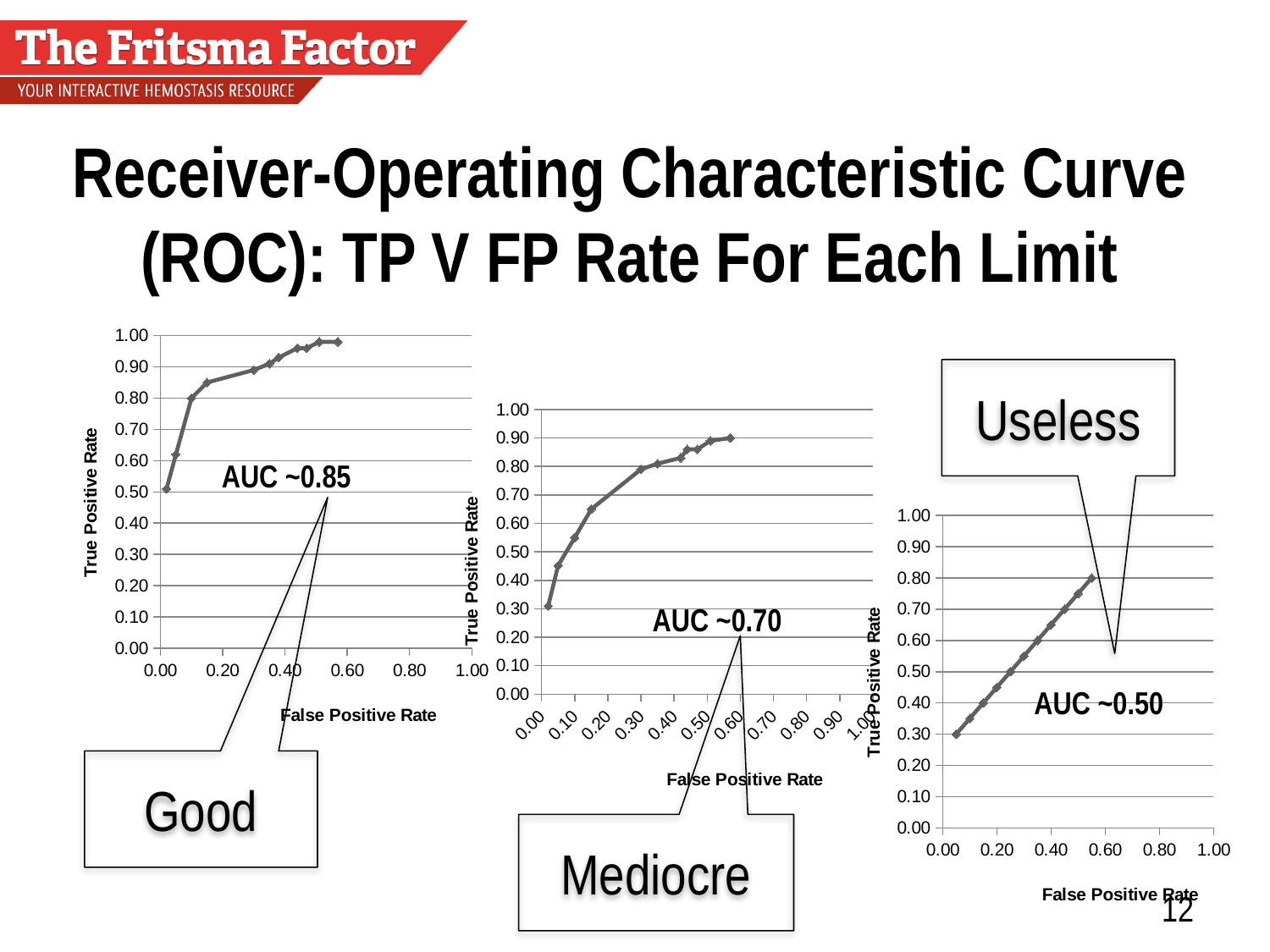
Which of the three charts reaches the lowest maximum true positive rate? the right chart (Useless) On the left chart labelled "Good", do the values rise or fall as the false positive rate increases? rise On the middle chart labelled "Mediocre", what is the label of the x axis? False Positive Rate On the left chart labelled "Good", is the true positive rate at a false positive rate of 0.20 greater or less than 0.80? greater On the left chart labelled "Good", what is the label of the y axis? True Positive Rate On the left chart labelled "Good", is the highest true positive rate reached by the curve greater or less than 0.90? greater On the right chart labelled "Useless", is the true positive rate at a false positive rate of 0.40 greater or less than 0.60? greater What kind of chart is the left chart labelled "Good"? line chart Which of the three charts reaches the highest true positive rate? the left chart (Good) On the right chart labelled "Useless", do the values rise or fall along the x axis? rise How many charts are shown on the slide? 3